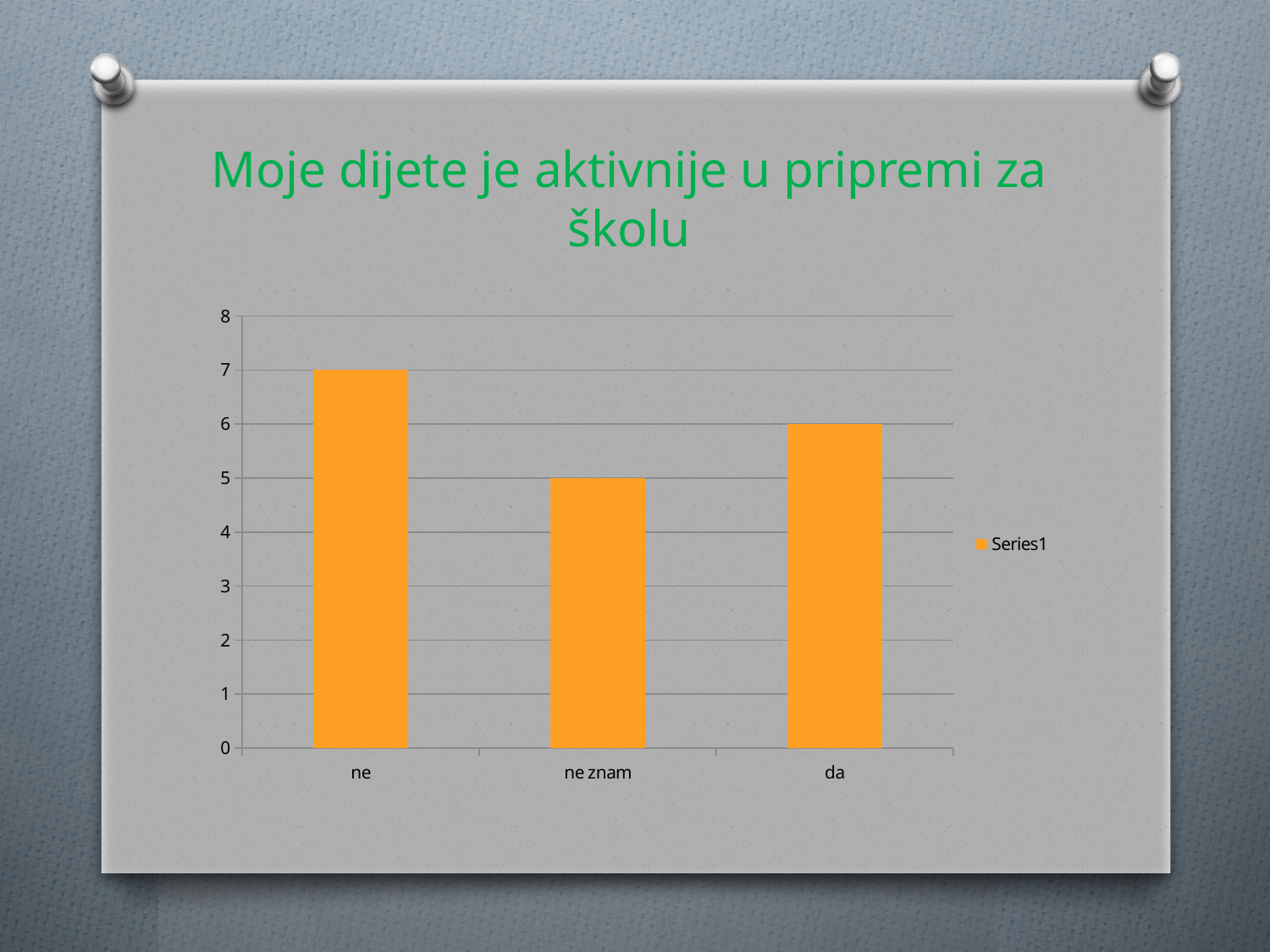
What is the difference between the values for "ne" and "ne znam"? 2 Which is larger, the value for "da" or the value for "ne"? ne What kind of chart is shown on the slide? bar chart How many series does the legend list? 1 How many categories are shown on the x axis? 3 What is the difference between the values for "da" and "ne znam"? 1 Which category has the highest value? ne What is the value for "ne"? 7 Which category has the lowest value? ne znam What is the value for "da"? 6 What is the value for "ne znam"? 5 Is the value for "ne znam" greater or less than 6? less